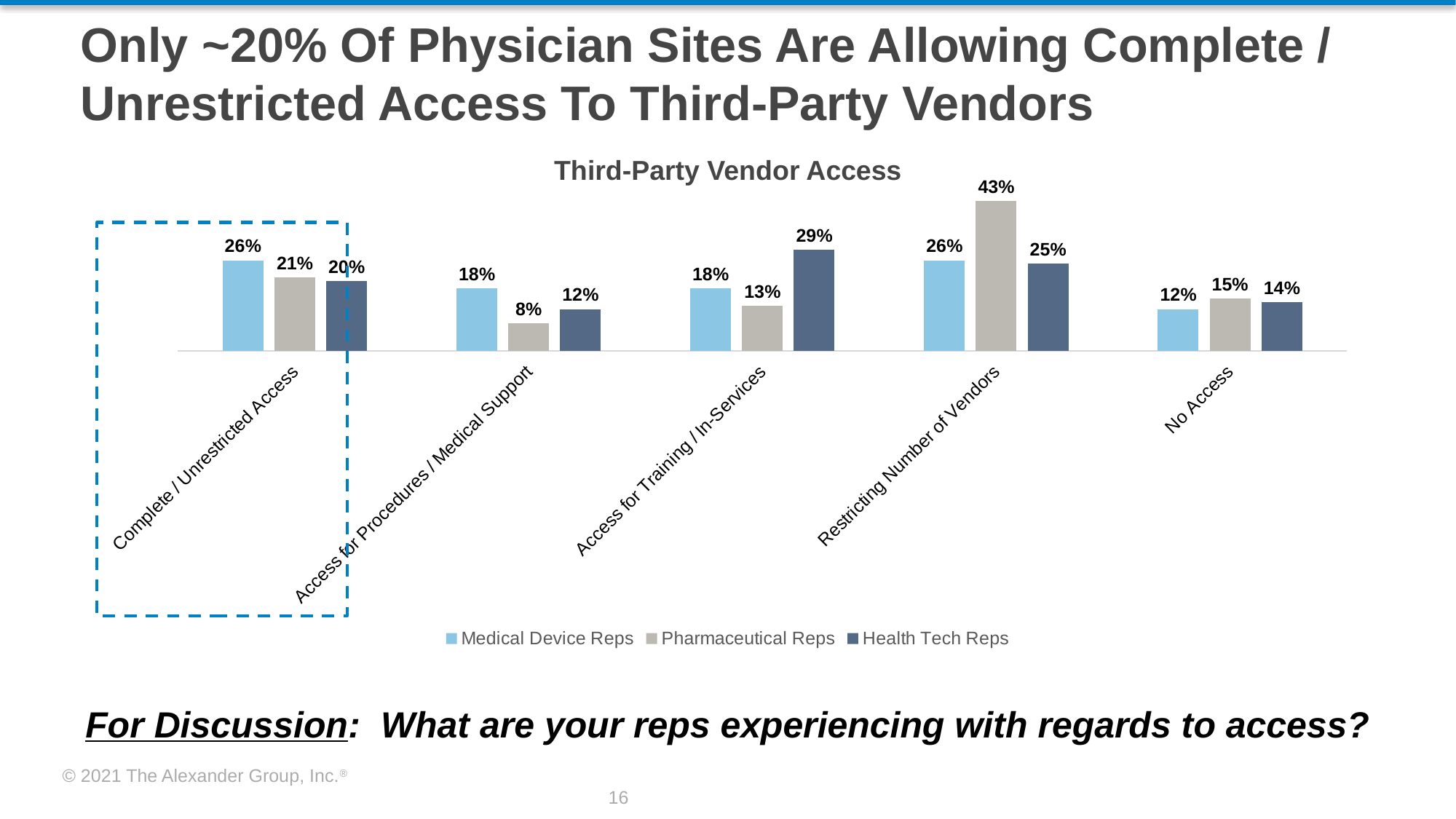
What kind of chart is shown on the slide? Bar chart In the Access for Procedures / Medical Support category, which is larger: Medical Device Reps or Health Tech Reps? Medical Device Reps Which category has the lowest value for Medical Device Reps? No Access What is the title of the chart? Third-Party Vendor Access What is the value for Pharmaceutical Reps in the Restricting Number of Vendors category? 43% What is the value for Health Tech Reps in the Access for Training / In-Services category? 29% What is the value for Medical Device Reps in the Complete / Unrestricted Access category? 26% Which category is highlighted with a dashed box on the chart? Complete / Unrestricted Access Which category has the highest value for Pharmaceutical Reps? Restricting Number of Vendors How many categories are shown on the x axis? 5 How many series does the legend list? 3 What is the difference between the Pharmaceutical Reps value and the Medical Device Reps value in the Restricting Number of Vendors category? 17%